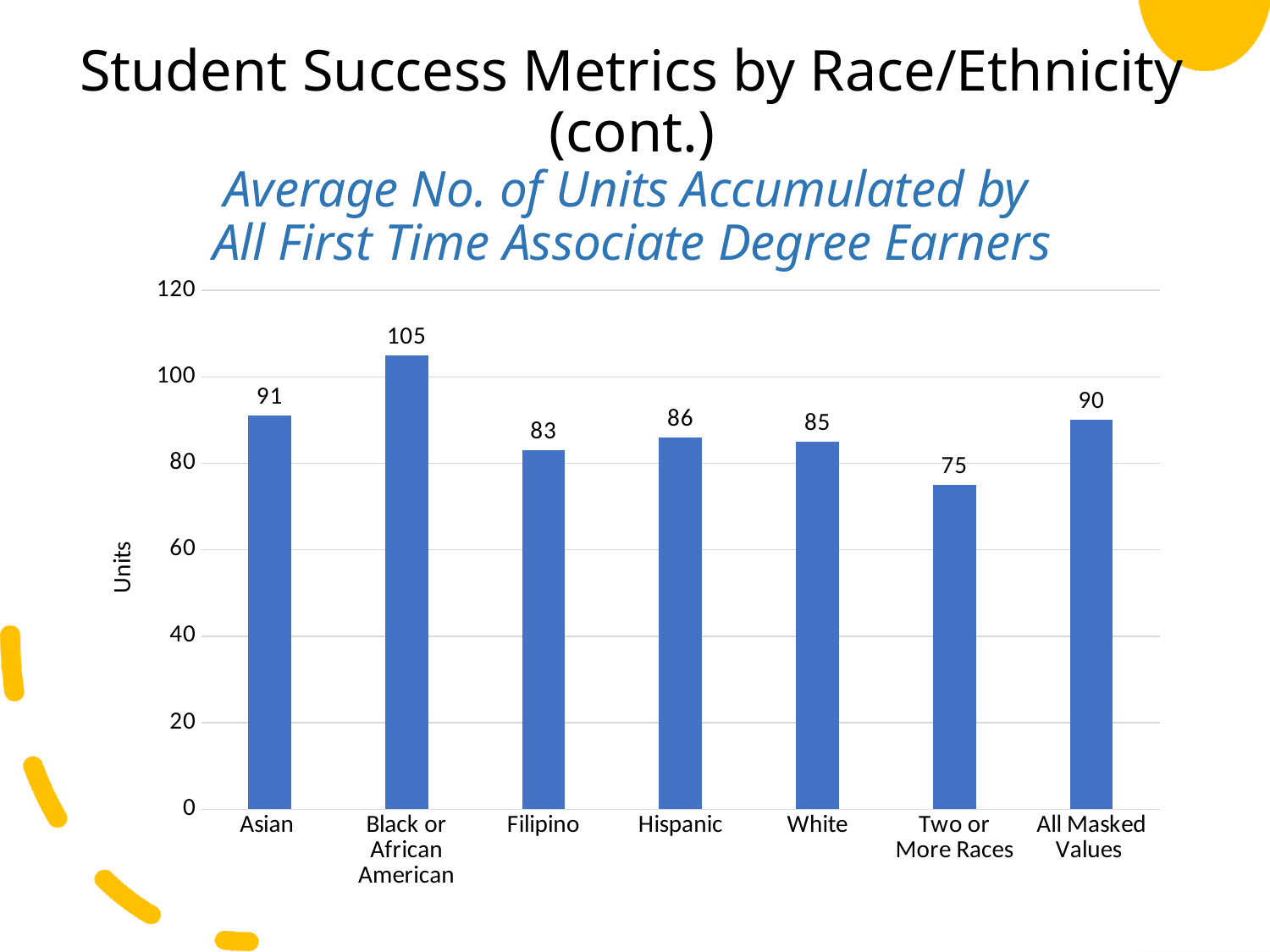
What kind of chart is shown on the slide? Bar chart Which category has the lowest average number of units? Two or More Races Which category has the highest average number of units? Black or African American Is the value for All Masked Values greater or less than 80? greater What is the average number of units accumulated by Asian first time associate degree earners? 91 Which is larger, the value for Hispanic or the value for White? Hispanic What is the value shown for Two or More Races? 75 How many race/ethnicity categories are shown on the chart? 7 What is the difference between the values for Asian and Filipino? 8 What is the value shown for Black or African American? 105 What is the label on the vertical axis of the chart? Units What is the difference between the values for Black or African American and Two or More Races? 30